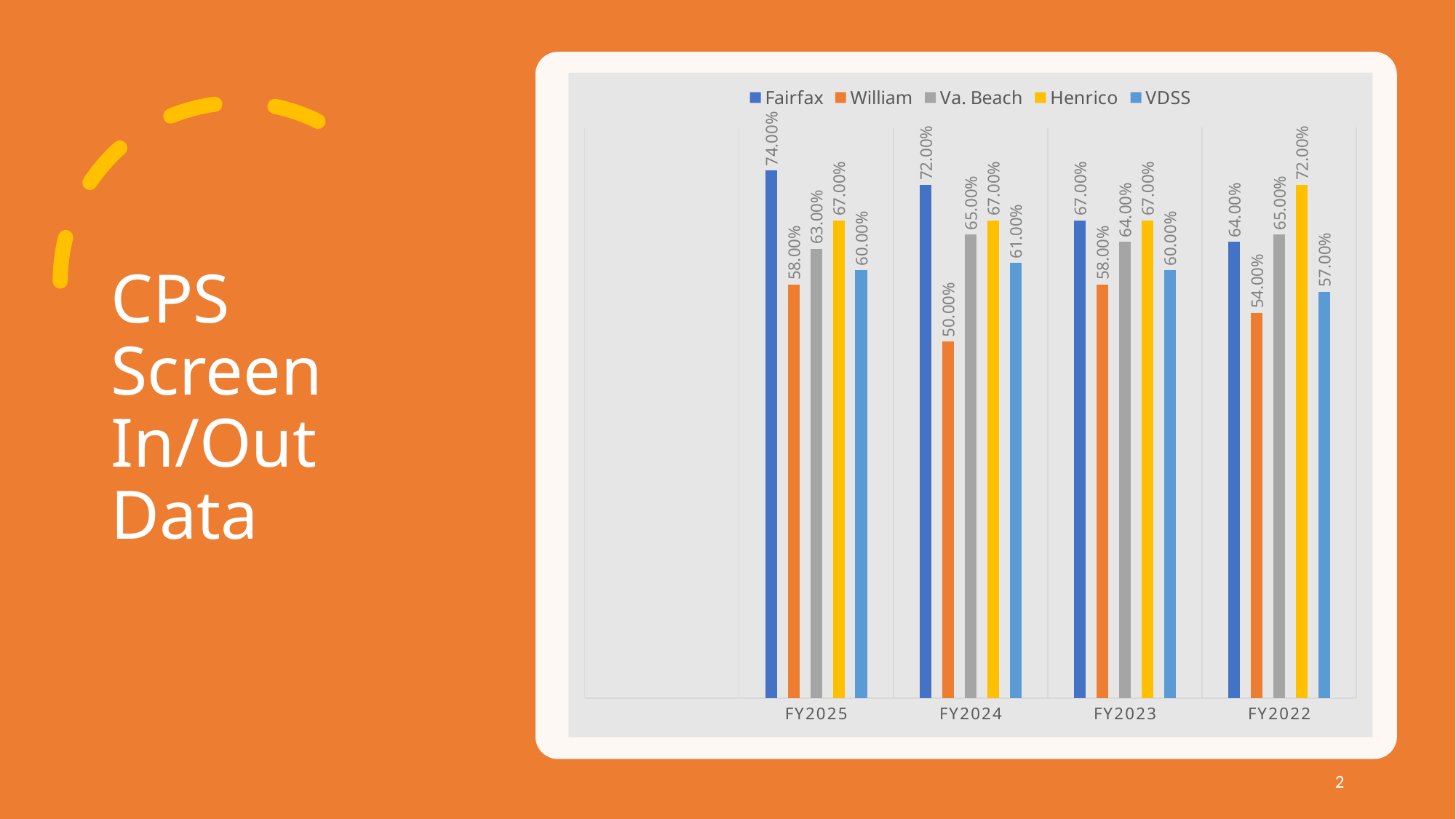
How many series does the legend list? 5 What is the value for William in FY2024? 50.00% What is the difference between the Fairfax and William values in FY2024? 22.00% Which series has the highest value in FY2025? Fairfax Which series has the lowest value in FY2022? William What is the value for Henrico in FY2022? 72.00% What kind of chart is shown on the slide? Bar chart Which series is shown in yellow in the legend? Henrico How many fiscal year categories are shown on the x axis? 4 Which is larger in FY2022, the Va. Beach value or the Fairfax value? Va. Beach What is the value for VDSS in FY2023? 60.00% What is the value for Fairfax in FY2025? 74.00%